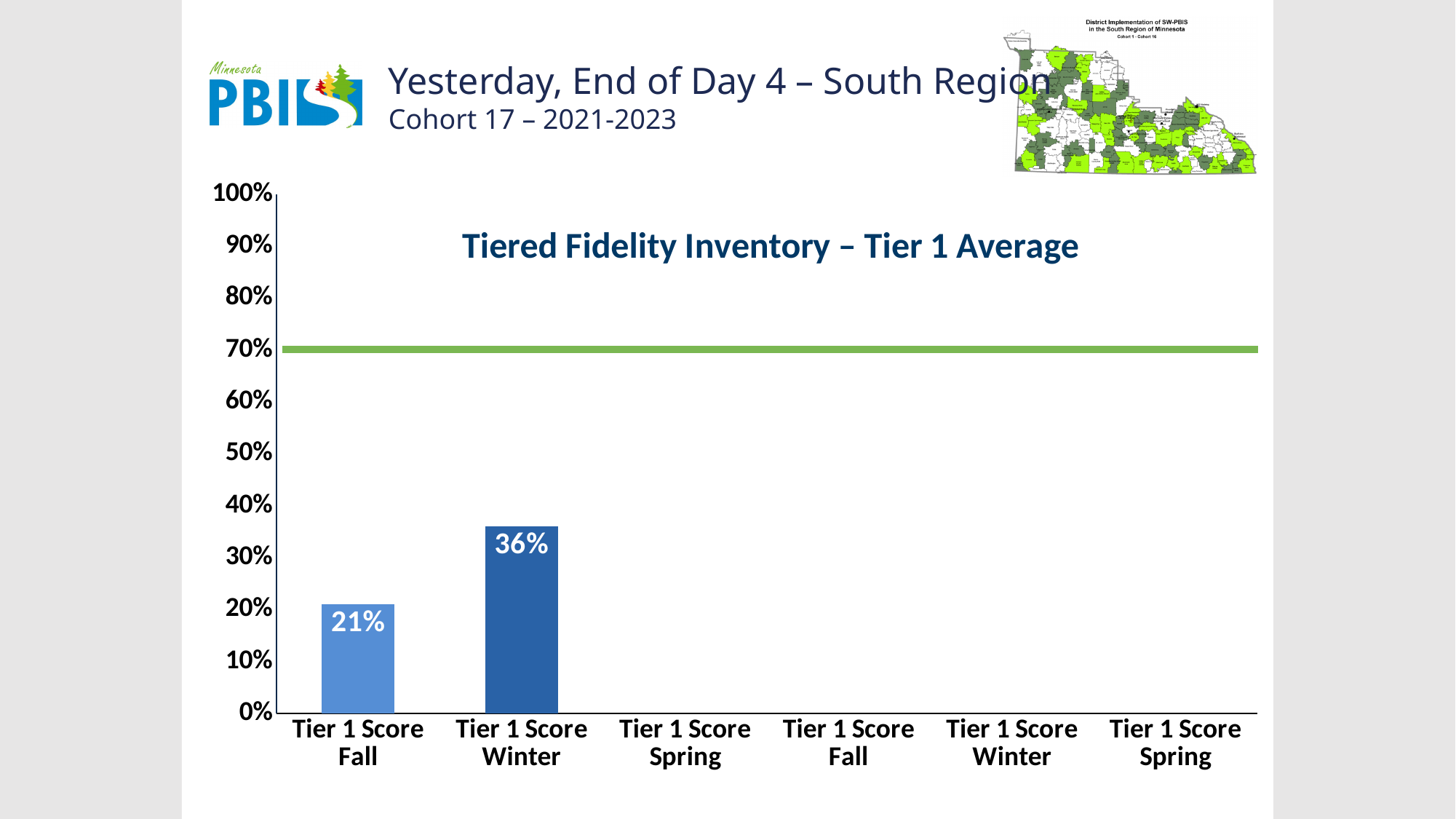
What is the value of the leftmost bar, Tier 1 Score Fall? 21% Which category has the highest plotted bar? Tier 1 Score Winter What is the difference between the Tier 1 Score Winter bar and the leftmost Tier 1 Score Fall bar? 15% What kind of chart is shown on the slide? bar chart Do the plotted values rise or fall from Tier 1 Score Fall to Tier 1 Score Winter? rise Which of the plotted bars is the lowest? Tier 1 Score Fall What is the title of the chart? Tiered Fidelity Inventory – Tier 1 Average Which is larger, the Tier 1 Score Winter bar or the leftmost Tier 1 Score Fall bar? Tier 1 Score Winter What is the value of the Tier 1 Score Winter bar? 36% Is the value for Tier 1 Score Winter greater or less than 40%? less How many bars are actually plotted on the chart? 2 How many category labels are shown along the x axis? 6